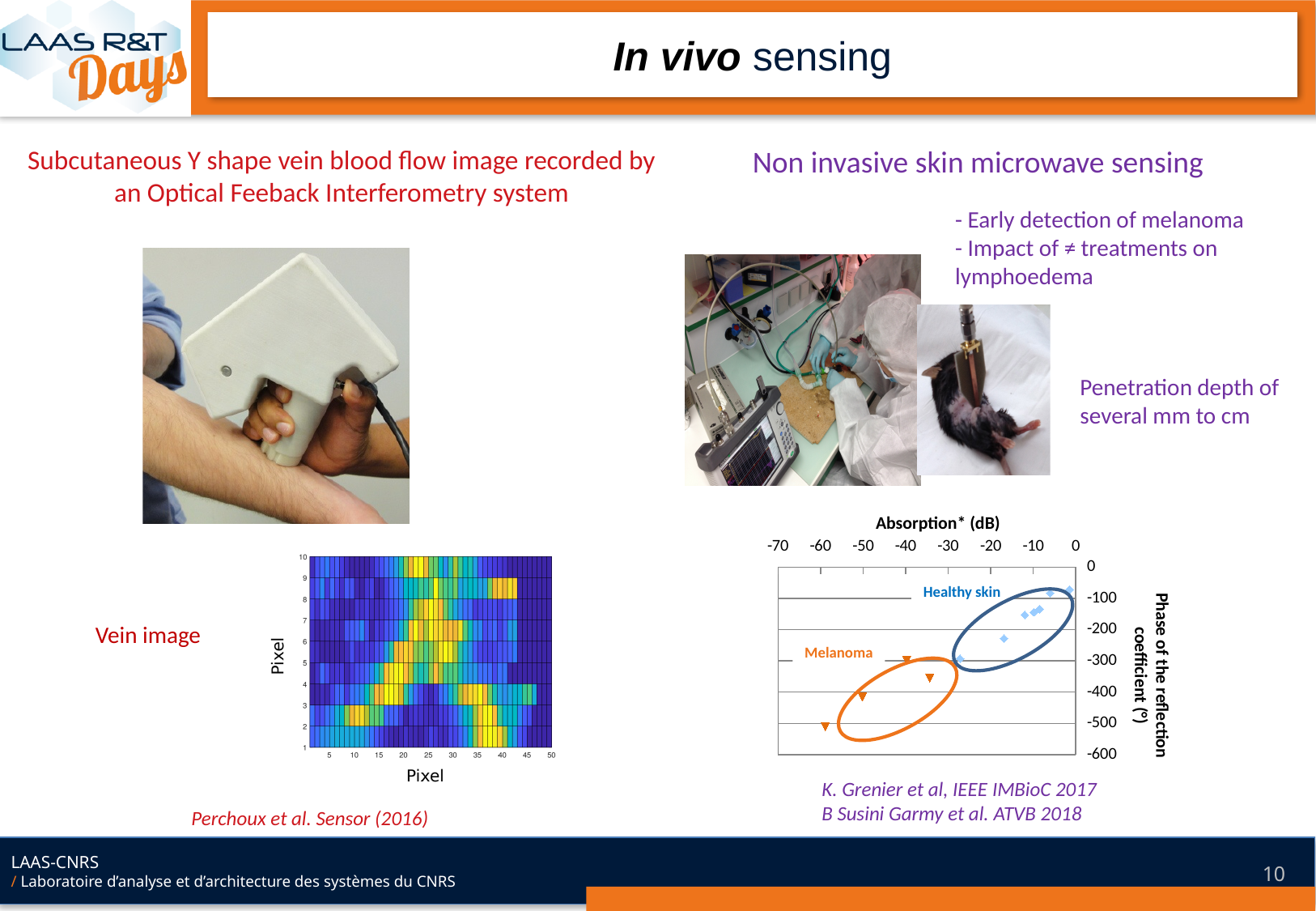
In the scatter chart, which group has the more negative phase values, Healthy skin or Melanoma? Melanoma What is the title of the vertical axis of the scatter chart? Phase of the reflection coefficient (°) What is the title of the horizontal axis of the scatter chart? Absorption* (dB) In the scatter chart, is the absorption of the leftmost Melanoma point greater or less than -50 dB? less In the scatter chart, does the phase of the reflection coefficient rise or fall as absorption increases from -70 toward 0 dB? rise In the scatter chart, which group has the higher absorption values, Healthy skin or Melanoma? Healthy skin In the scatter chart, is the absorption of every Healthy skin point greater or less than -40 dB? greater What kind of chart is shown at the bottom right of the slide? scatter chart What is the lowest value shown on the vertical axis of the scatter chart? -600 In the scatter chart, how many groups of points are labelled? 2 In the scatter chart, how many Melanoma points are plotted? 4 In the scatter chart, is the phase of the lowest Melanoma point greater or less than -400°? less